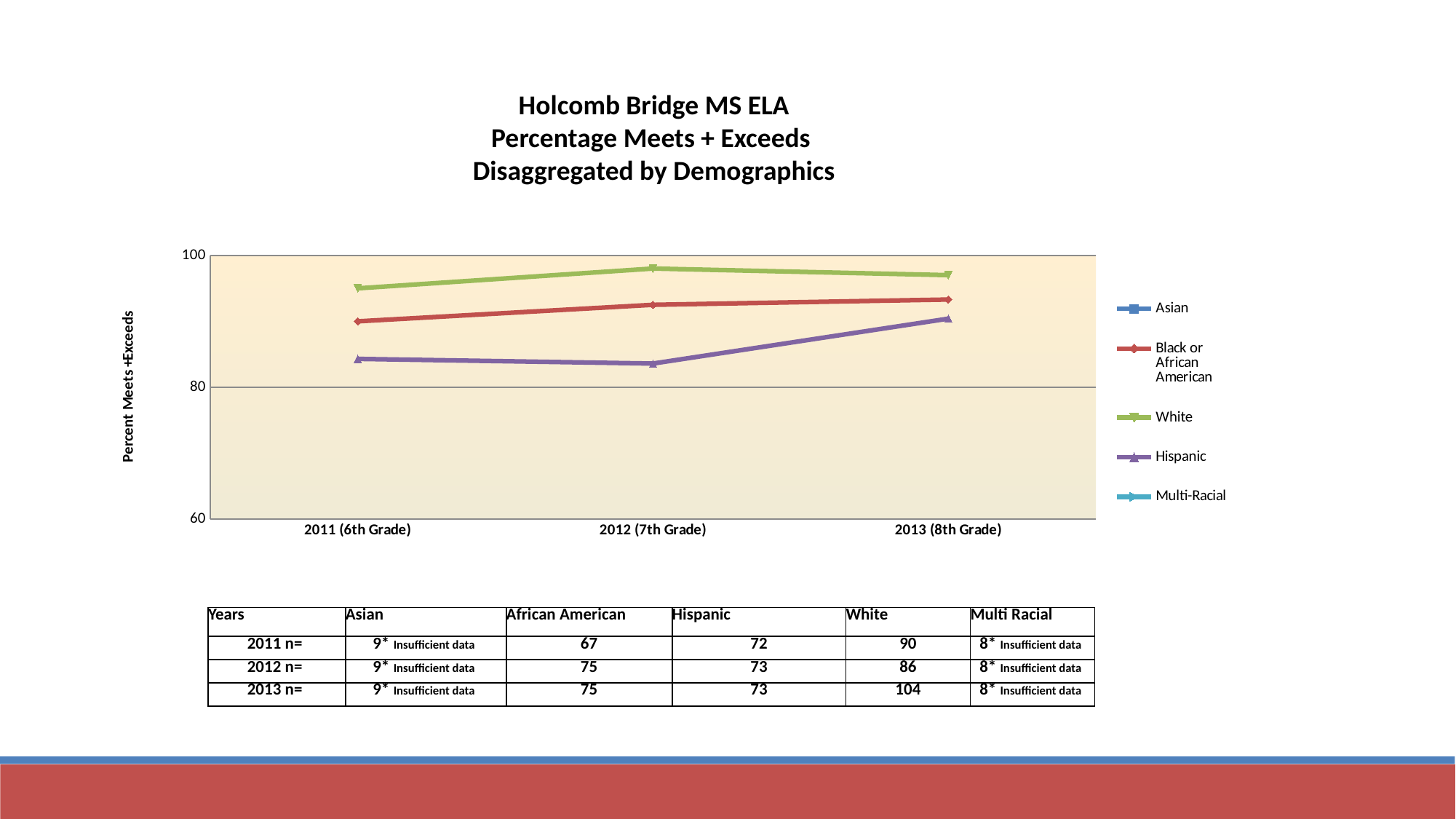
Is the value for White in 2011 (6th Grade) greater or less than 80? greater How many series does the chart legend list? 5 Which series has the highest value in 2012 (7th Grade)? White Which plotted series has the lowest value in 2011 (6th Grade)? Hispanic What is the label on the vertical axis of the chart? Percent Meets +Exceeds What kind of chart is shown on the slide? line chart In 2011 (6th Grade), which is larger: the value for White or the value for Hispanic? White Is the value for White in 2012 (7th Grade) greater or less than 100? less Is the value for Hispanic in 2013 (8th Grade) greater or less than 80? greater Does the Hispanic line rise or fall from 2012 (7th Grade) to 2013 (8th Grade)? rise Does the Black or African American line rise or fall from 2011 (6th Grade) to 2013 (8th Grade)? rise How many points are shown along the x axis of the chart? 3